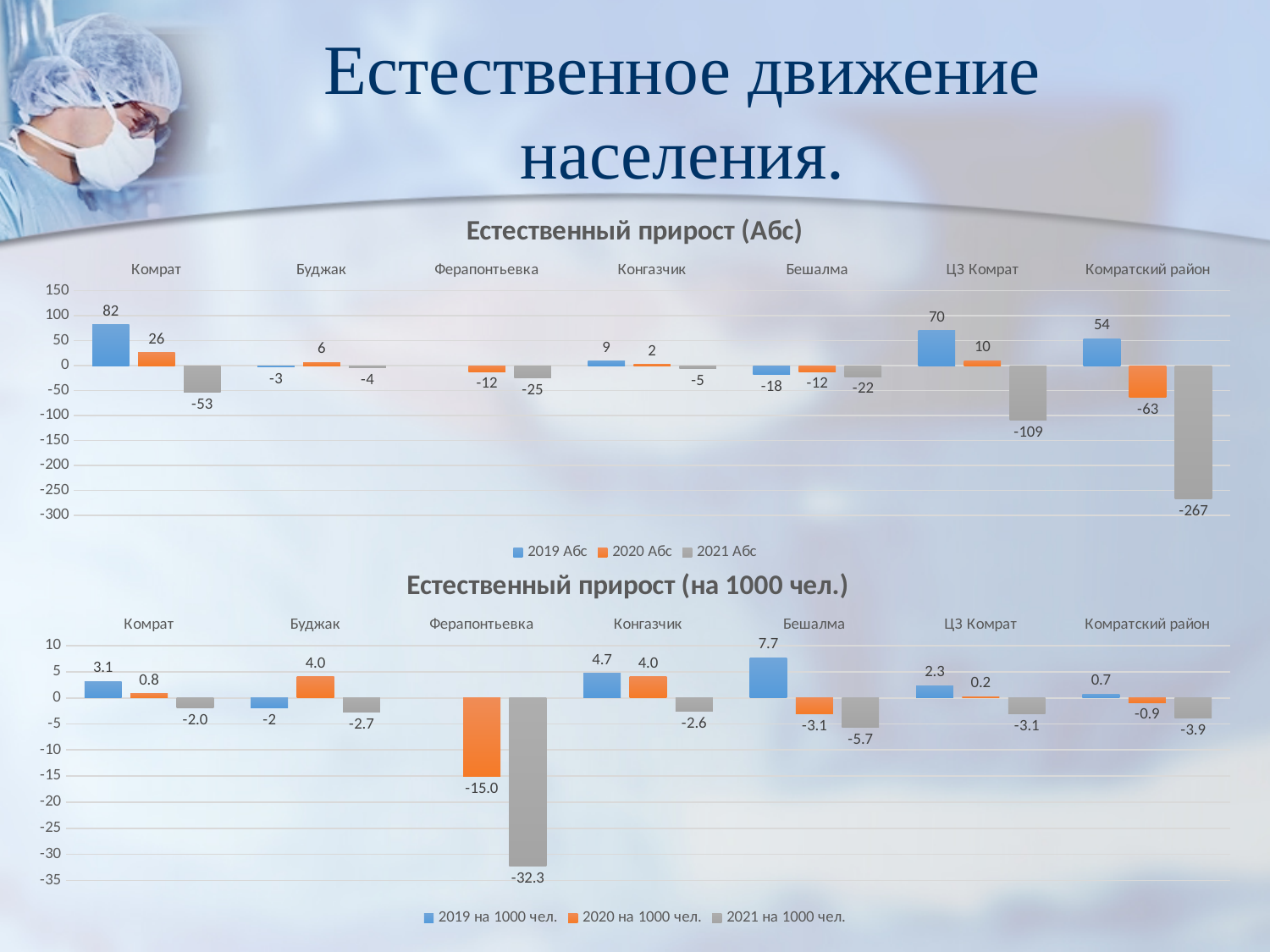
In the chart 'Естественный прирост (Абс)', which is larger: the 2020 Абс value for Комрат or for ЦЗ Комрат? Комрат In the chart 'Естественный прирост (на 1000 чел.)', what is the 2021 на 1000 чел. value for Ферапонтьевка? -32.3 In the chart 'Естественный прирост (Абс)', what is the difference between the 2019 Абс values for Комрат and ЦЗ Комрат? 12 In the chart 'Естественный прирост (Абс)', how many series does the legend list? 3 In the chart 'Естественный прирост (на 1000 чел.)', what is the 2020 на 1000 чел. value for Буджак? 4.0 In the chart 'Естественный прирост (Абс)', what is the 2019 Абс value for Комрат? 82 In the chart 'Естественный прирост (на 1000 чел.)', how many categories are shown on the x axis? 7 In the chart 'Естественный прирост (Абс)', what is the 2021 Абс value for Комратский район? -267 In the chart 'Естественный прирост (Абс)', which category has the lowest 2021 Абс value? Комратский район What type of chart is 'Естественный прирост (на 1000 чел.)'? Bar chart In the chart 'Естественный прирост (на 1000 чел.)', what is the difference between the 2019 and 2020 values for Конгазчик? 0.7 In the chart 'Естественный прирост (на 1000 чел.)', which category has the highest 2019 на 1000 чел. value? Бешалма